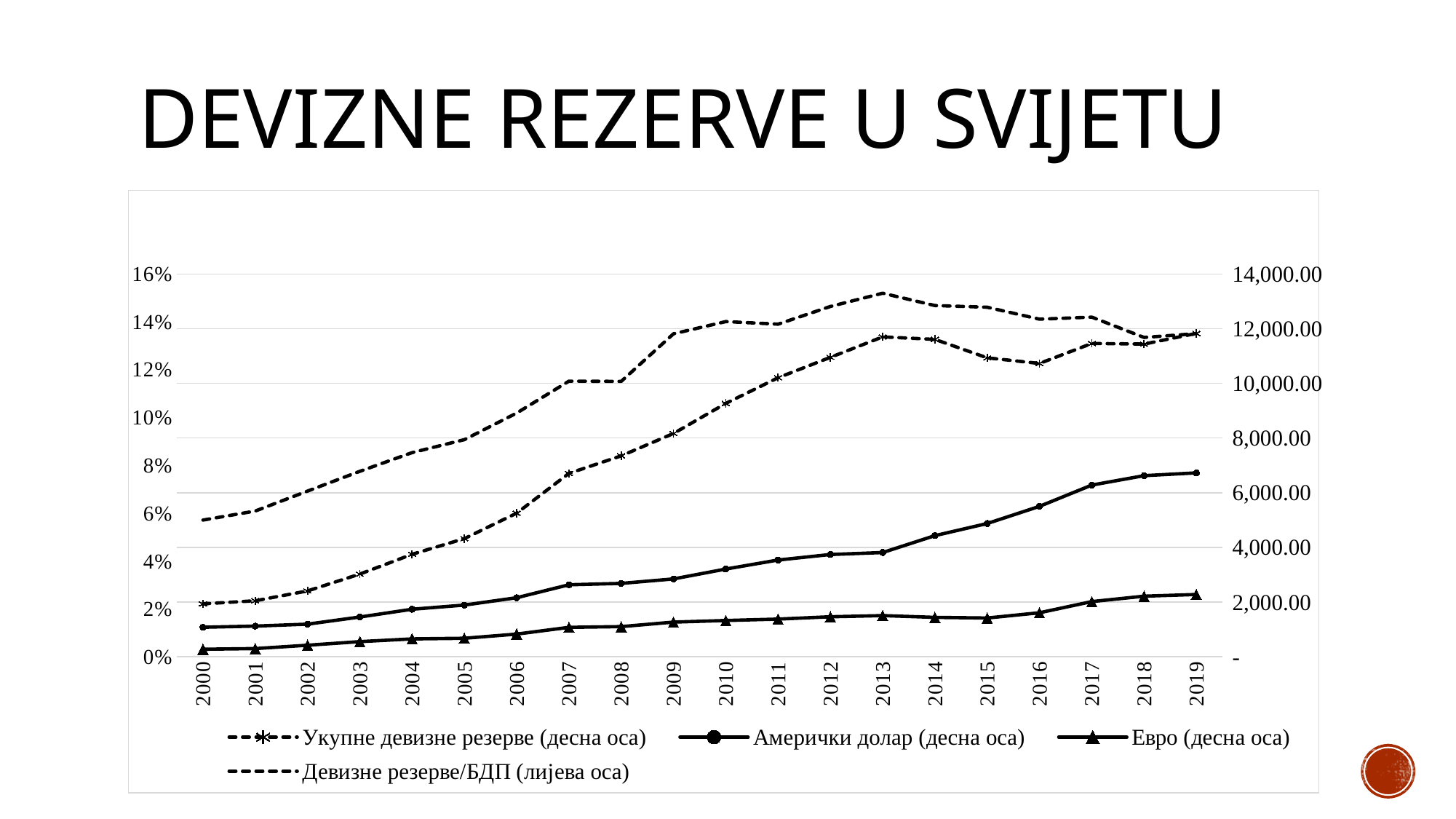
Does the Амерички долар series rise or fall from 2000 to 2019? rise Is the value for Амерички долар in 2019 greater or less than 6,000.00? greater In which year is the Евро series at its lowest? 2000 Which series is plotted against the left axis according to the legend? Девизне резерве/БДП (лијева оса) In 2019, which is larger: Амерички долар or Евро? Амерички долар How many series does the legend list? 4 How many years are plotted along the x axis? 20 Is the value for Евро in 2019 greater or less than 4,000.00? less Is the value for Укупне девизне резерве in 2010 greater or less than 8,000.00? greater What kind of chart is shown on the slide? line chart What is the title of the slide containing the chart? DEVIZNE REZERVE U SVIJETU